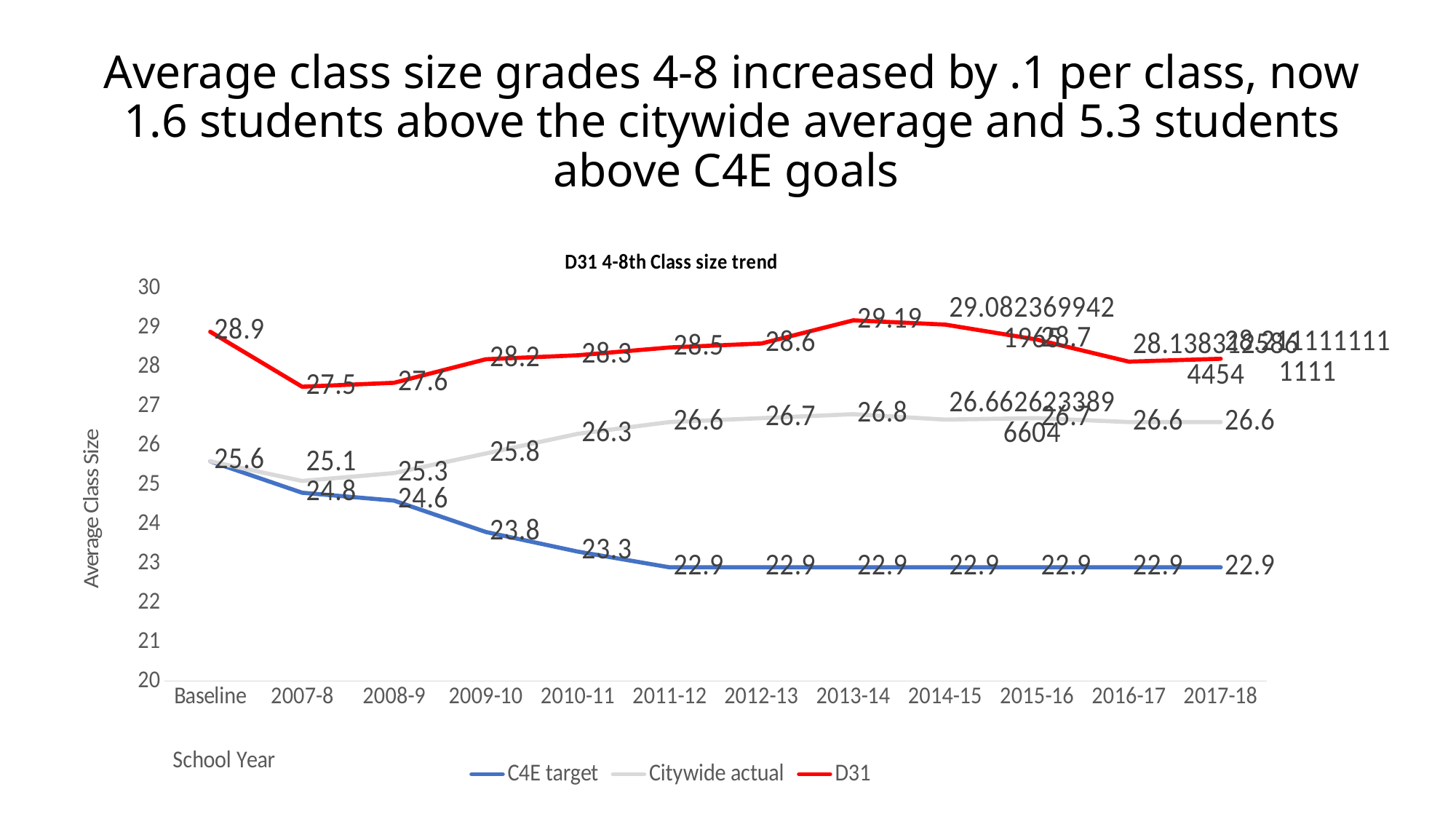
How many series does the legend list? 3 Does the C4E target line rise or fall from Baseline to 2011-12? fall In which school year does the D31 line reach its highest value? 2013-14 What is the title of the chart? D31 4-8th Class size trend What is the difference between the D31 value and the C4E target value in 2013-14? 6.29 What is the Citywide actual value for 2012-13? 26.7 What is the D31 value for 2013-14? 29.19 How many school-year categories are shown on the x axis? 12 What is the D31 value for 2007-8? 27.5 Which is larger in 2010-11, the D31 value or the Citywide actual value? D31 What is the C4E target value for 2009-10? 23.8 What kind of chart is shown on the slide? line chart